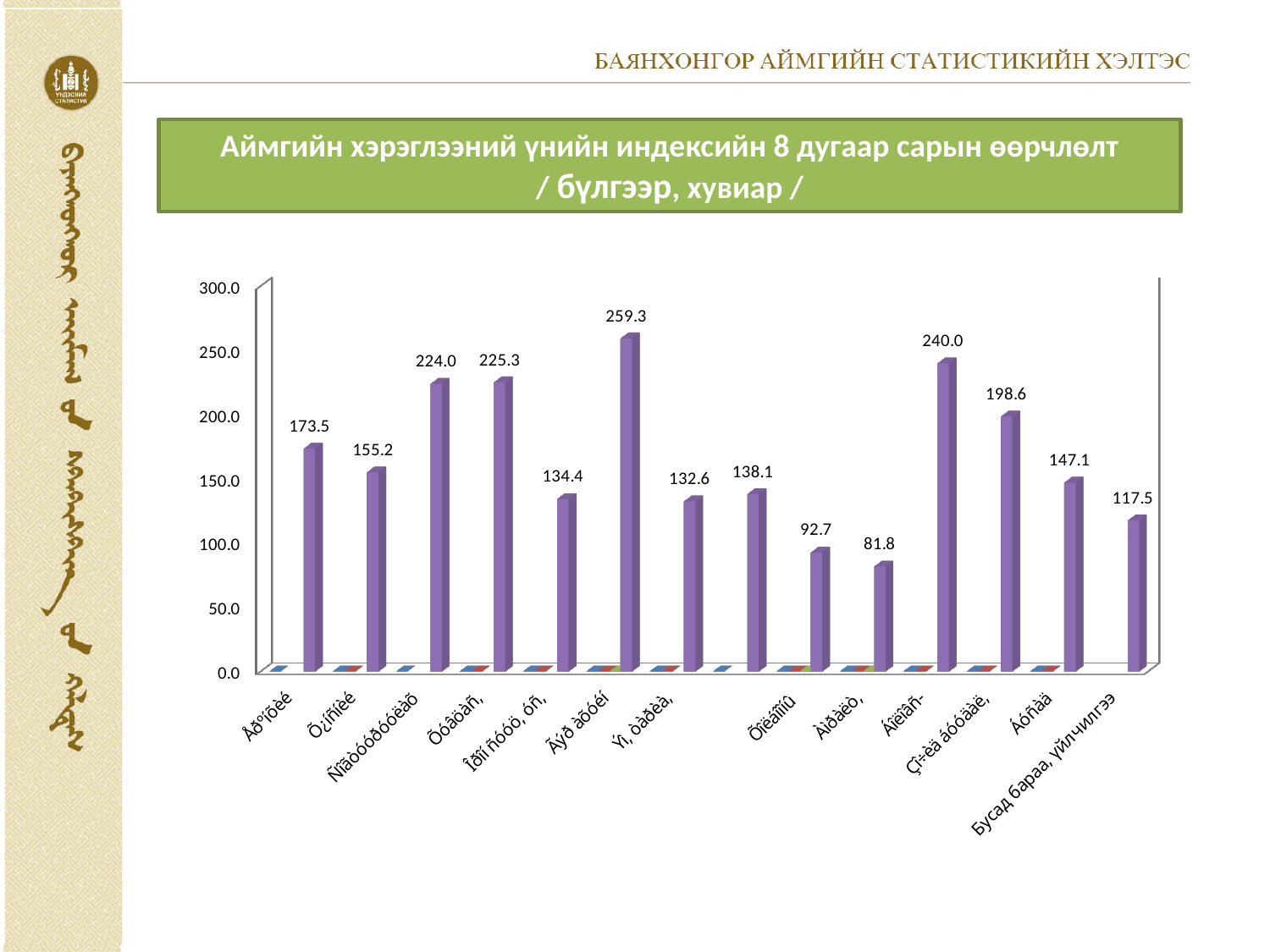
Is the value for 'Бусад бараа, үйлчилгээ' greater or less than 100? greater How many bars (categories) are plotted in the chart? 14 What is the highest value shown in the chart? 259.3 What is the title of the chart on the slide? Аймгийн хэрэглээний үнийн индексийн 8 дугаар сарын өөрчлөлт / бүлгээр, хувиар / How many bars in the chart have a value below 100? 2 What is the lowest value shown in the chart? 81.8 What kind of chart is shown on the slide? Bar chart What is the value for the category 'Бусад бараа, үйлчилгээ'? 117.5 What is the value of the first (leftmost) bar in the chart? 173.5 What is the difference between the highest value (259.3) and the lowest value (81.8) in the chart? 177.5 Is the highest bar in the chart greater or less than 250? greater How many bars in the chart have a value above 200? 4